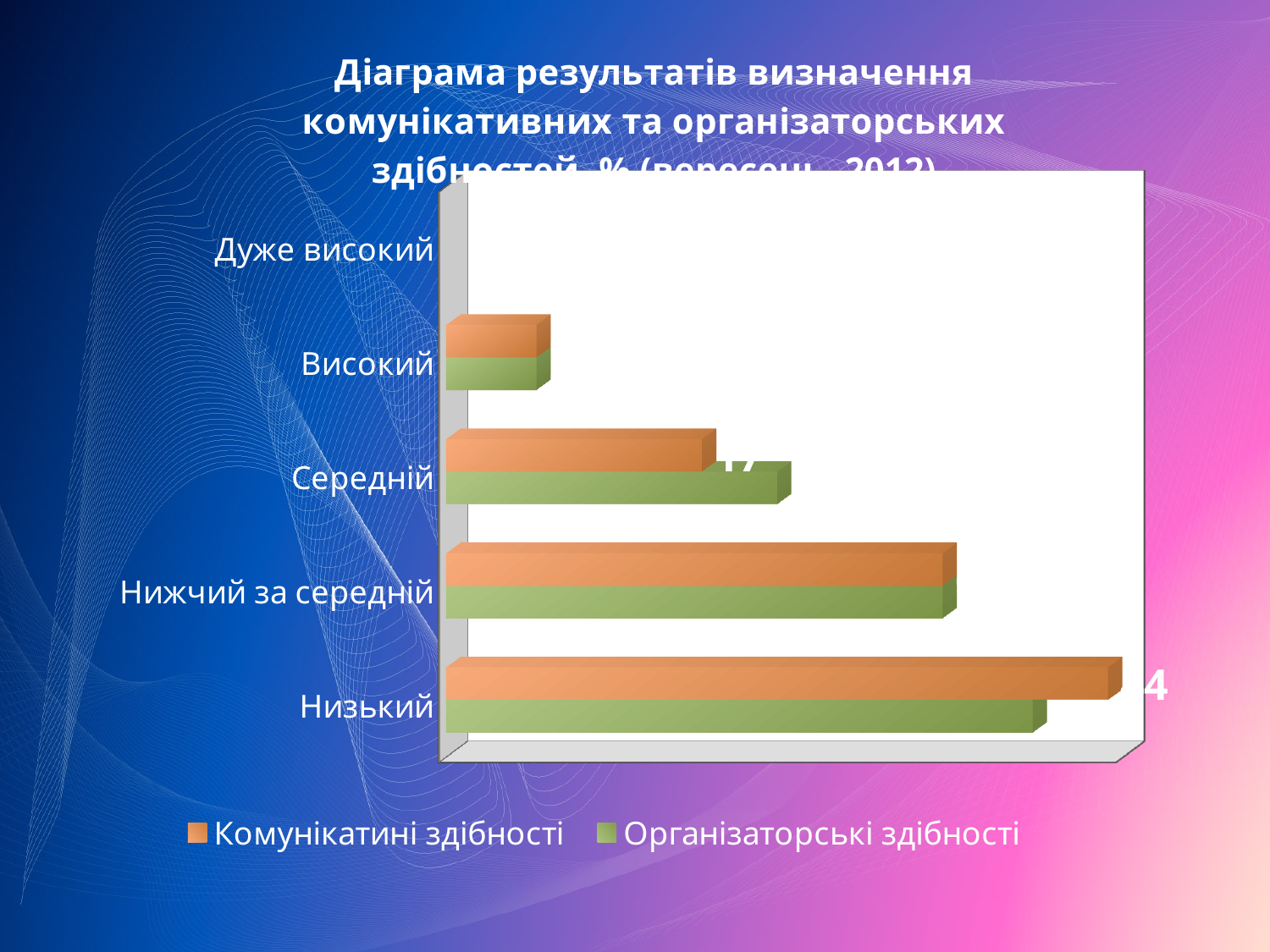
Which category has the longest bar for Комунікатині здібності? Низький For the category Низький, which series has the larger value: Комунікатині здібності or Організаторські здібності? Комунікатині здібності How many categories are shown on the vertical axis of the chart? 5 What are the two series named in the chart legend? Комунікатині здібності and Організаторські здібності Which category has the longest bar for Організаторські здібності? Низький For the category Середній, which series has the larger value: Комунікатині здібності or Організаторські здібності? Організаторські здібності Which is larger for Комунікатині здібності: the value for Високий or the value for Нижчий за середній? Нижчий за середній How many series does the chart legend list? 2 Which colour represents Організаторські здібності in the chart? Green Which category has the shortest bars for both series? Дуже високий Do the bar lengths rise or fall when moving from Низький up to Дуже високий? Fall What kind of chart is shown on the slide? Bar chart